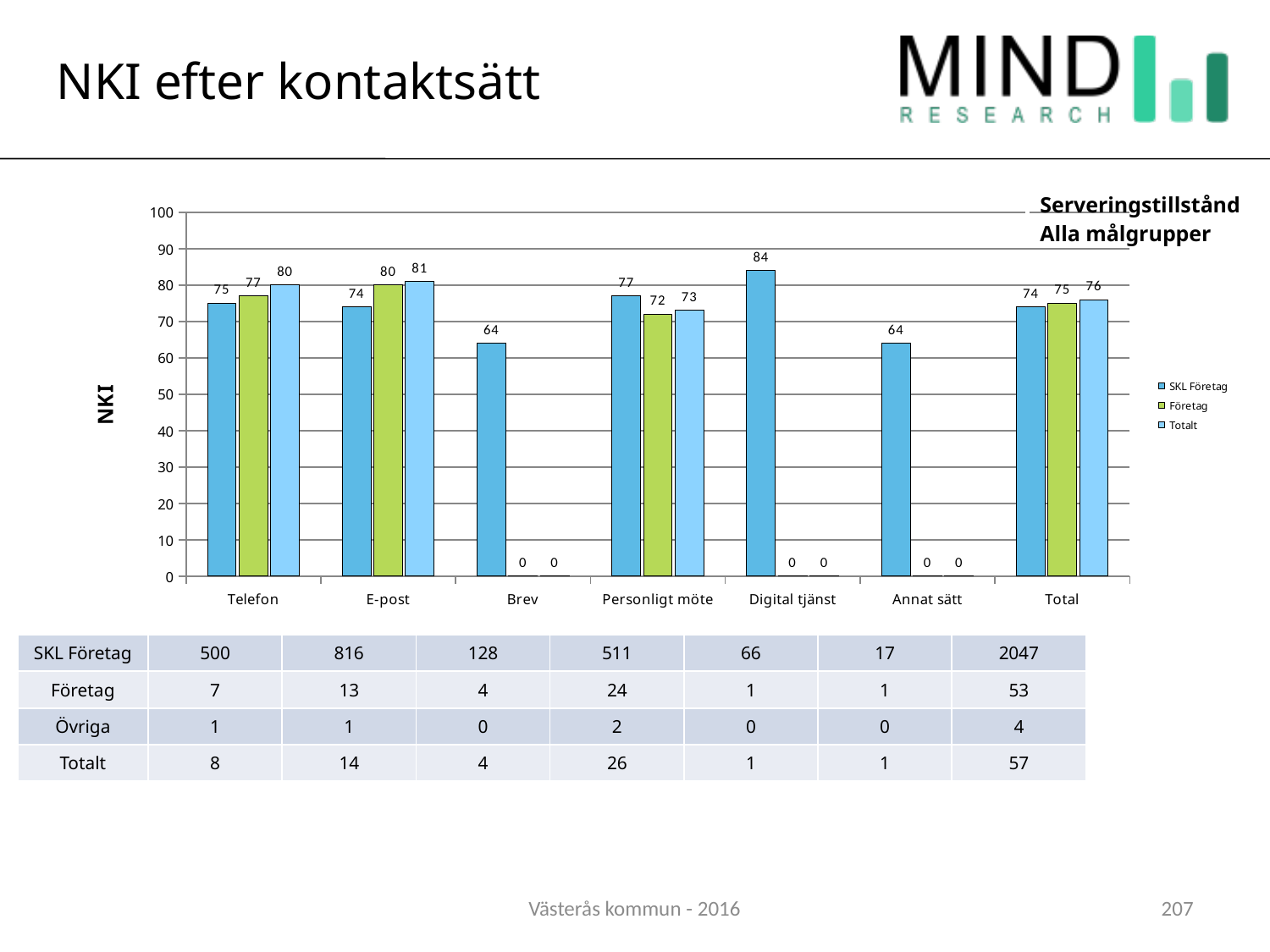
What kind of chart is shown on the slide? Bar chart What is the NKI value for SKL Företag in the Digital tjänst category? 84 Which category has the highest SKL Företag value? Digital tjänst Which category has the lowest Totalt value among those with a non-zero value? Personligt möte What is the NKI value for SKL Företag in the Telefon category? 75 How many series does the legend list? 3 What is the NKI value for Totalt in the E-post category? 81 What is the label of the y axis? NKI Which is larger in the Personligt möte category: the SKL Företag value or the Företag value? SKL Företag What is the difference between the Totalt value and the SKL Företag value in the Telefon category? 5 What is the Företag value in the Total category? 75 How many categories are shown on the x axis? 7